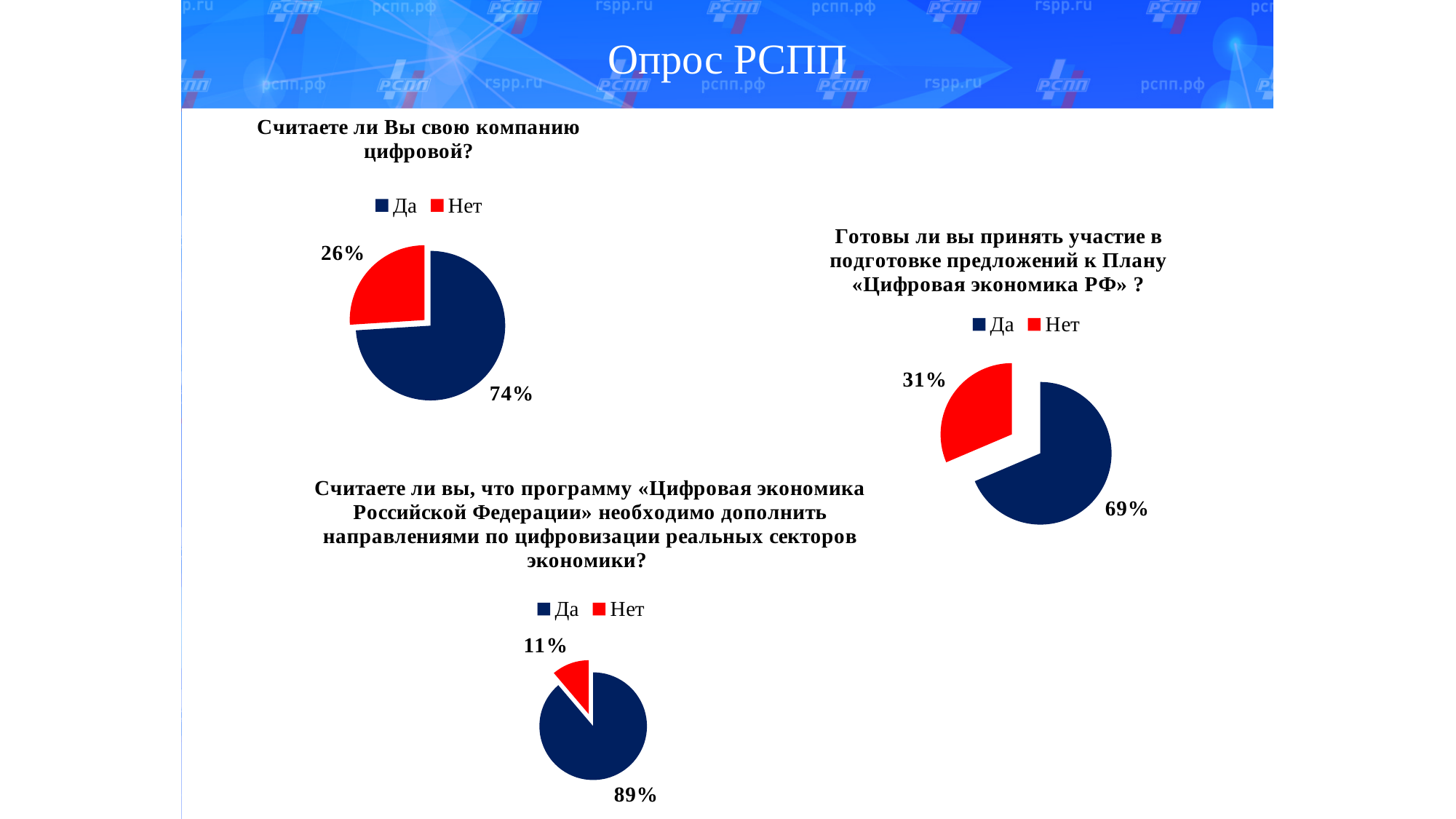
How many series does the legend of the right pie chart 'Готовы ли вы принять участие...' list? 2 In the bottom pie chart about supplementing the 'Цифровая экономика Российской Федерации' programme, which answer has the smallest share? Нет What type of chart is used for the three charts on the slide? Pie chart In the right pie chart 'Готовы ли вы принять участие...', what is the difference between the 'Да' and 'Нет' shares? 38% In the top-left pie chart 'Считаете ли Вы свою компанию цифровой?', what share answered 'Нет'? 26% In the top-left pie chart 'Считаете ли Вы свою компанию цифровой?', what share answered 'Да'? 74% Is the 'Да' share in the bottom pie chart (89%) larger or smaller than the 'Да' share in the top-left pie chart (74%)? larger In the right pie chart 'Готовы ли вы принять участие в подготовке предложений к Плану «Цифровая экономика РФ»?', what share answered 'Да'? 69% In the top-left pie chart 'Считаете ли Вы свою компанию цифровой?', which answer has the larger share? Да In the bottom pie chart about supplementing the 'Цифровая экономика Российской Федерации' programme, what share answered 'Нет'? 11% In the bottom pie chart about supplementing the 'Цифровая экономика Российской Федерации' programme, what share answered 'Да'? 89% In the right pie chart 'Готовы ли вы принять участие в подготовке предложений к Плану «Цифровая экономика РФ»?', what share answered 'Нет'? 31%